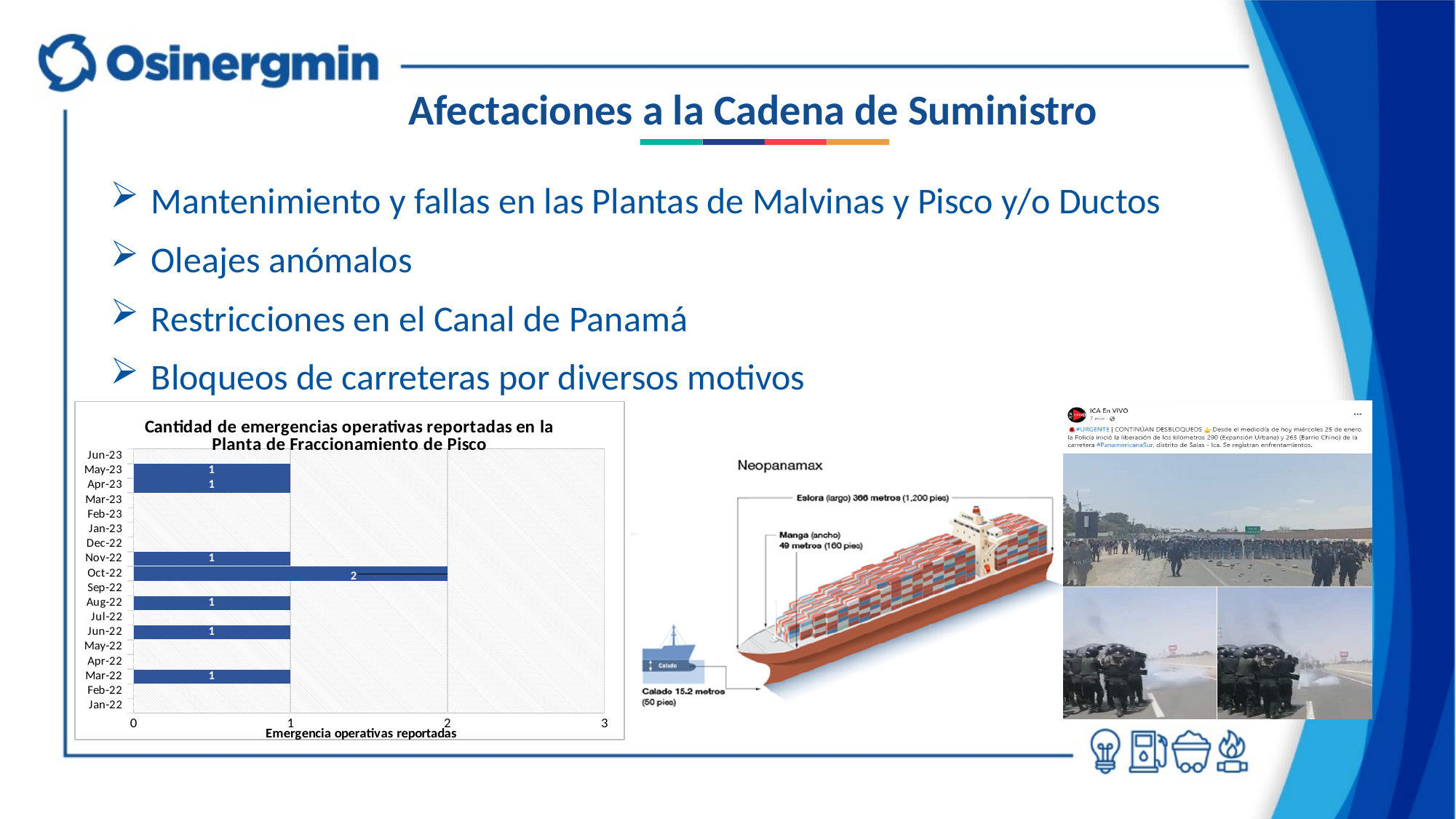
What is the value for Mar-22 in the chart? 1 How many months are listed on the vertical axis of the chart? 18 What is the value for Oct-22 in the chart 'Cantidad de emergencias operativas reportadas en la Planta de Fraccionamiento de Pisco'? 2 Which month has the highest number of reported operational emergencies in the chart? Oct-22 What is the value for May-23 in the chart? 1 What is the label of the horizontal axis of the chart? Emergencia operativas reportadas What is the title of the chart on the slide? Cantidad de emergencias operativas reportadas en la Planta de Fraccionamiento de Pisco Which is larger, the value for Oct-22 or the value for Aug-22? Oct-22 Is the value for Oct-22 greater or less than 1? greater What is the difference between the values for Oct-22 and Nov-22? 1 What kind of chart is shown on the slide? Bar chart How many months in the chart have a bar with a data label (at least one reported emergency)? 7